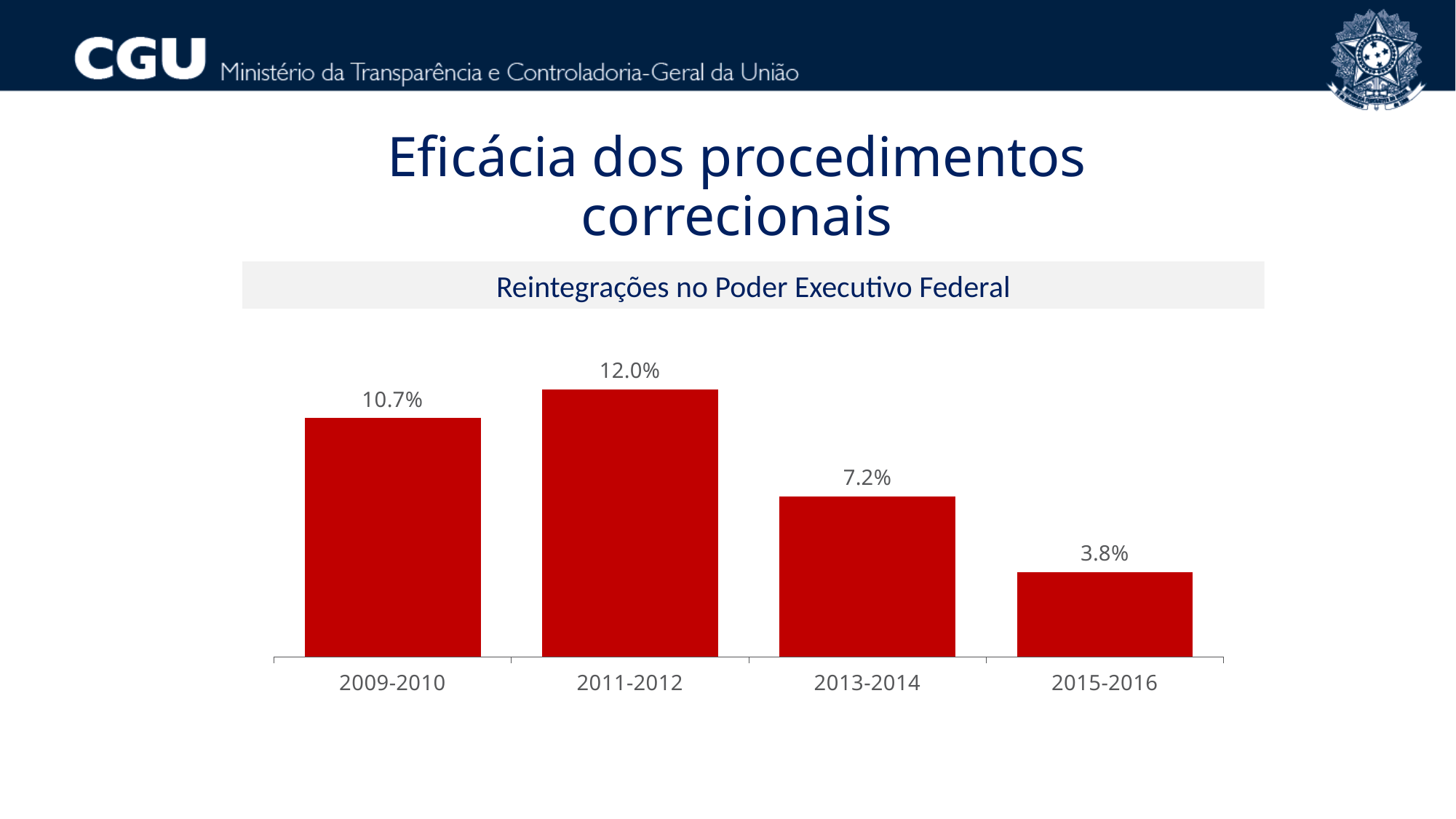
What is the value for 2011-2012? 12.0% What is the value for 2013-2014? 7.2% What kind of chart is shown on the slide? Bar chart Which period has the lowest value? 2015-2016 What is the value for 2009-2010? 10.7% What is the value for 2015-2016? 3.8% Which period has the highest value? 2011-2012 Which is larger, the value for 2009-2010 or the value for 2013-2014? 2009-2010 What is the difference between the values for 2011-2012 and 2015-2016? 8.2% How many periods are shown on the x axis? 4 What is the difference between the values for 2009-2010 and 2013-2014? 3.5% What is the title of the chart? Reintegrações no Poder Executivo Federal